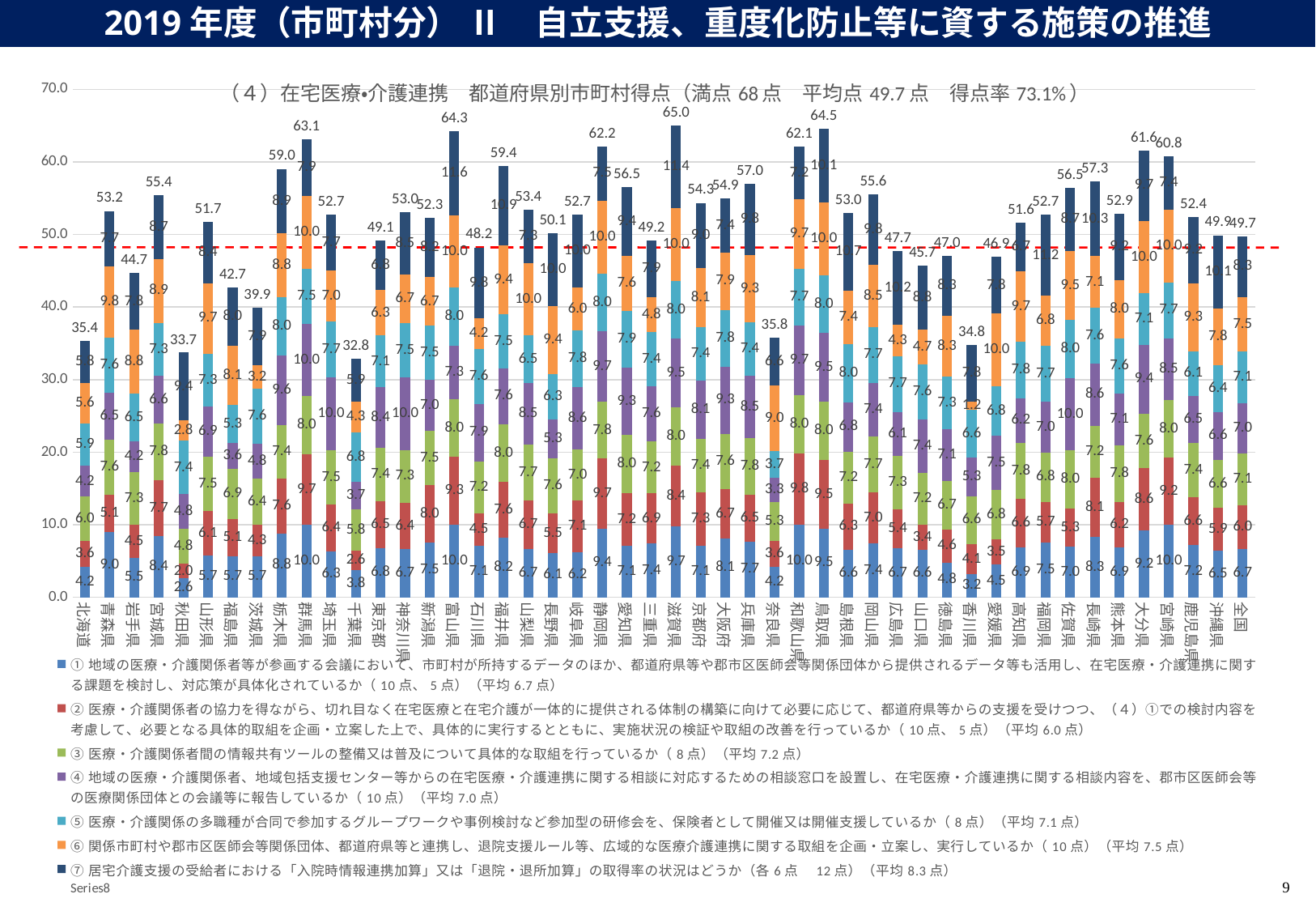
Which has a higher total score, 静岡県 or 愛知県? 静岡県 What is the total score shown for 滋賀県? 65.0 According to the chart title, what is the 平均点 (average score)? 49.7 点 What is the total score shown for 全国? 49.7 What kind of chart is shown on the slide? stacked bar chart Is the total score for 秋田県 greater or less than 40.0? less What is the total score shown for 北海道? 35.4 What is the total score shown for 群馬県? 63.1 How many bars are plotted on the chart? 48 Which prefecture has the highest total score? 滋賀県 What is the difference between the total scores of 滋賀県 and 千葉県? 32.2 Which prefecture has the lowest total score? 千葉県